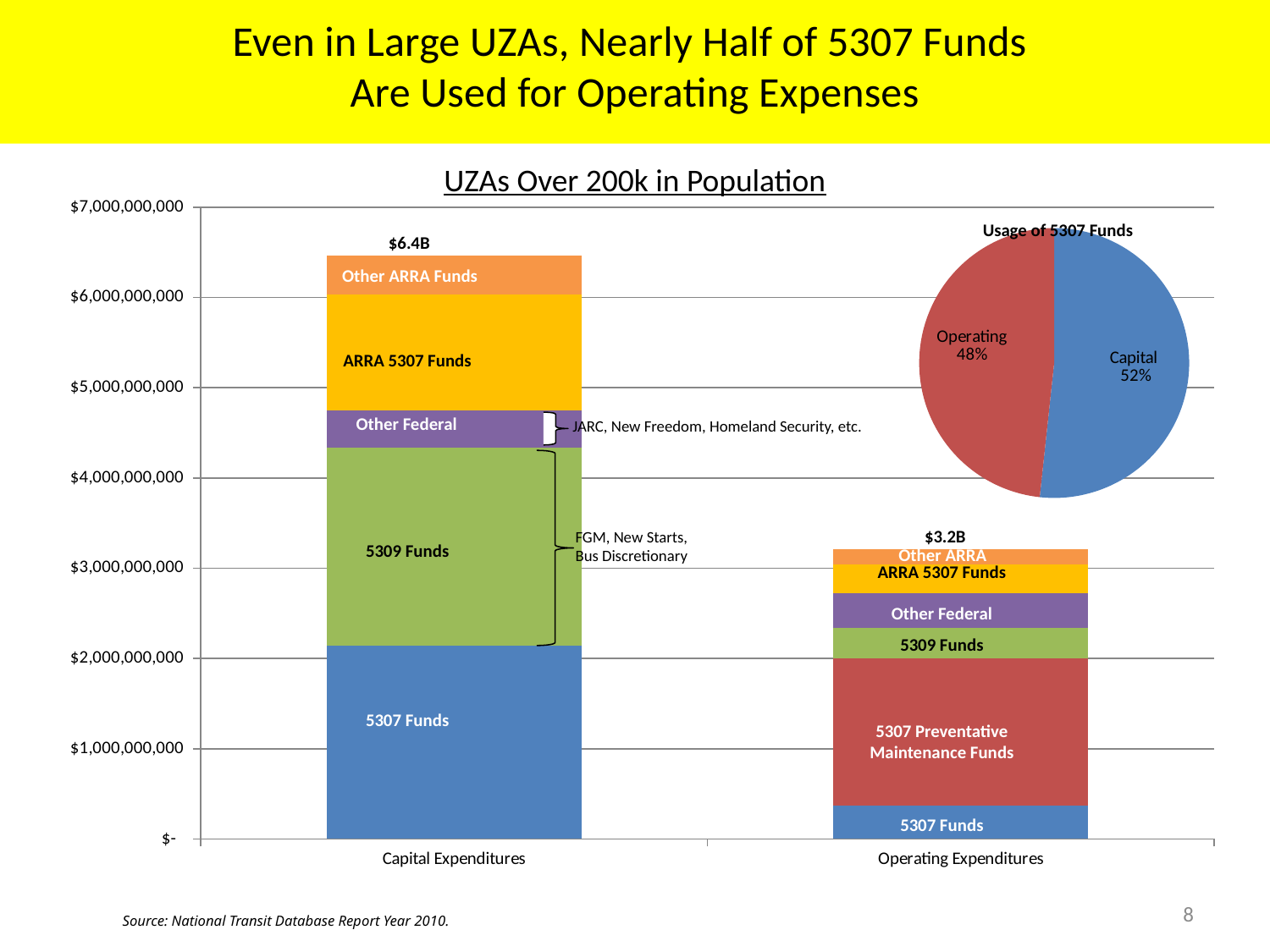
In the pie chart 'Usage of 5307 Funds', which slice is the largest? Capital In the bar chart 'UZAs Over 200k in Population', which segment of the Capital Expenditures bar is annotated 'JARC, New Freedom, Homeland Security, etc.'? Other Federal In the bar chart 'UZAs Over 200k in Population', what is the total labelled for the Capital Expenditures bar? $6.4B In the bar chart 'UZAs Over 200k in Population', is the total for Operating Expenditures greater or less than $3,000,000,000? greater In the pie chart 'Usage of 5307 Funds', what share is Capital? 52% How many expenditure categories are shown on the x axis of the bar chart 'UZAs Over 200k in Population'? 2 In the pie chart 'Usage of 5307 Funds', what share is Operating? 48% In the bar chart 'UZAs Over 200k in Population', what is the total labelled for the Operating Expenditures bar? $3.2B In the bar chart 'UZAs Over 200k in Population', which bar has the larger total, Capital Expenditures or Operating Expenditures? Capital Expenditures What kind of chart is 'UZAs Over 200k in Population'? Stacked bar chart In the bar chart 'UZAs Over 200k in Population', is the 5307 Funds segment of the Capital Expenditures bar greater or less than $3,000,000,000? less In the bar chart 'UZAs Over 200k in Population', what is the difference between the Capital Expenditures total and the Operating Expenditures total? $3.2B